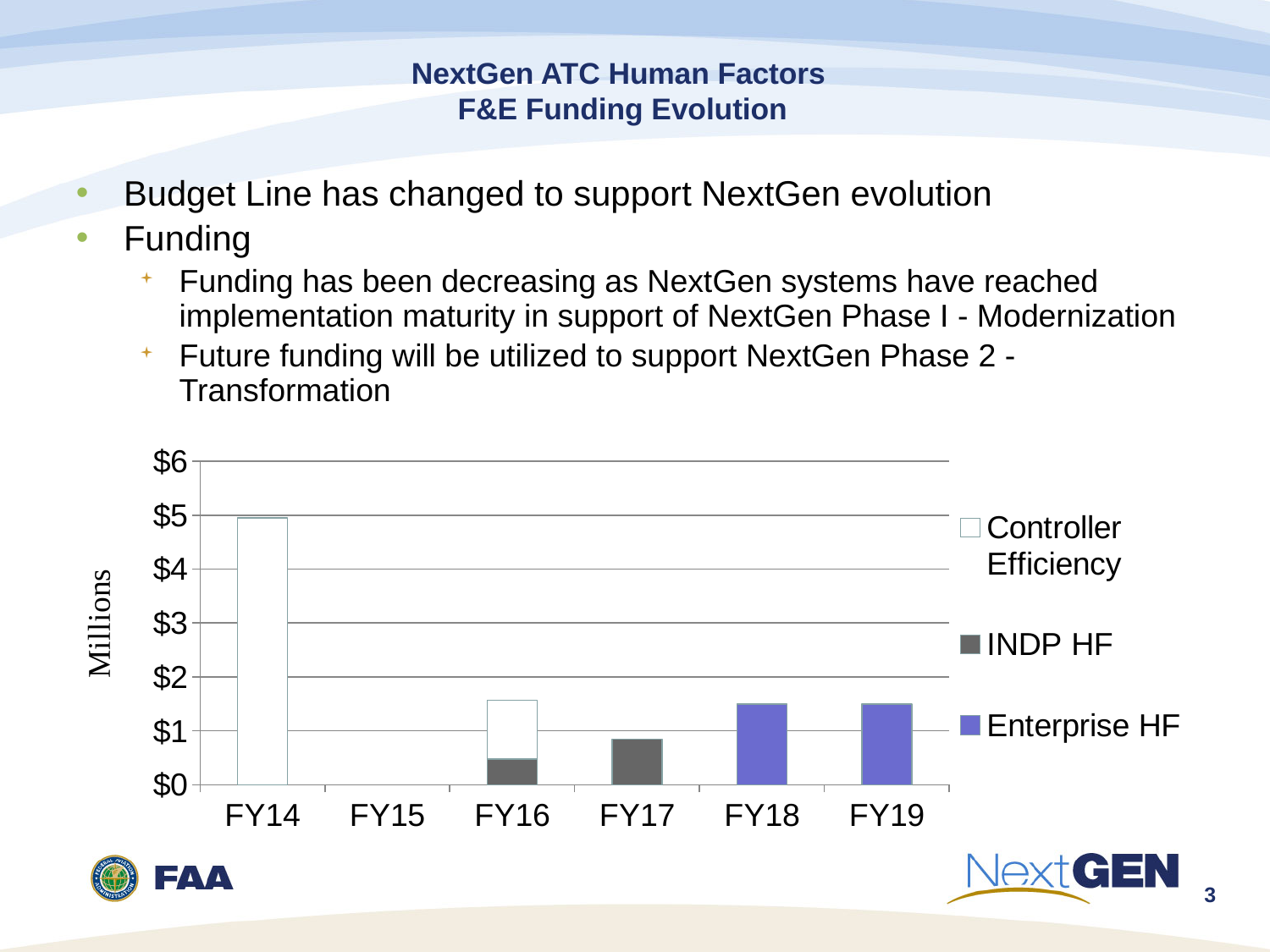
What kind of chart is shown on the slide? Stacked bar chart Does the total funding rise or fall from FY14 to FY17? fall How many series does the chart's legend list? 3 Is the value for FY14 greater or less than $4? greater Which series makes up the bar for FY18? Enterprise HF Is the total value for FY18 greater or less than $1? greater Which fiscal year has the highest total funding in the chart? FY14 Is the value for FY17 greater or less than $1? less How many fiscal year categories are shown on the x axis of the chart? 6 What is the label on the y axis of the chart? Millions Which fiscal year shows no bar at all in the chart? FY15 Which is larger, the total funding for FY14 or for FY17? FY14